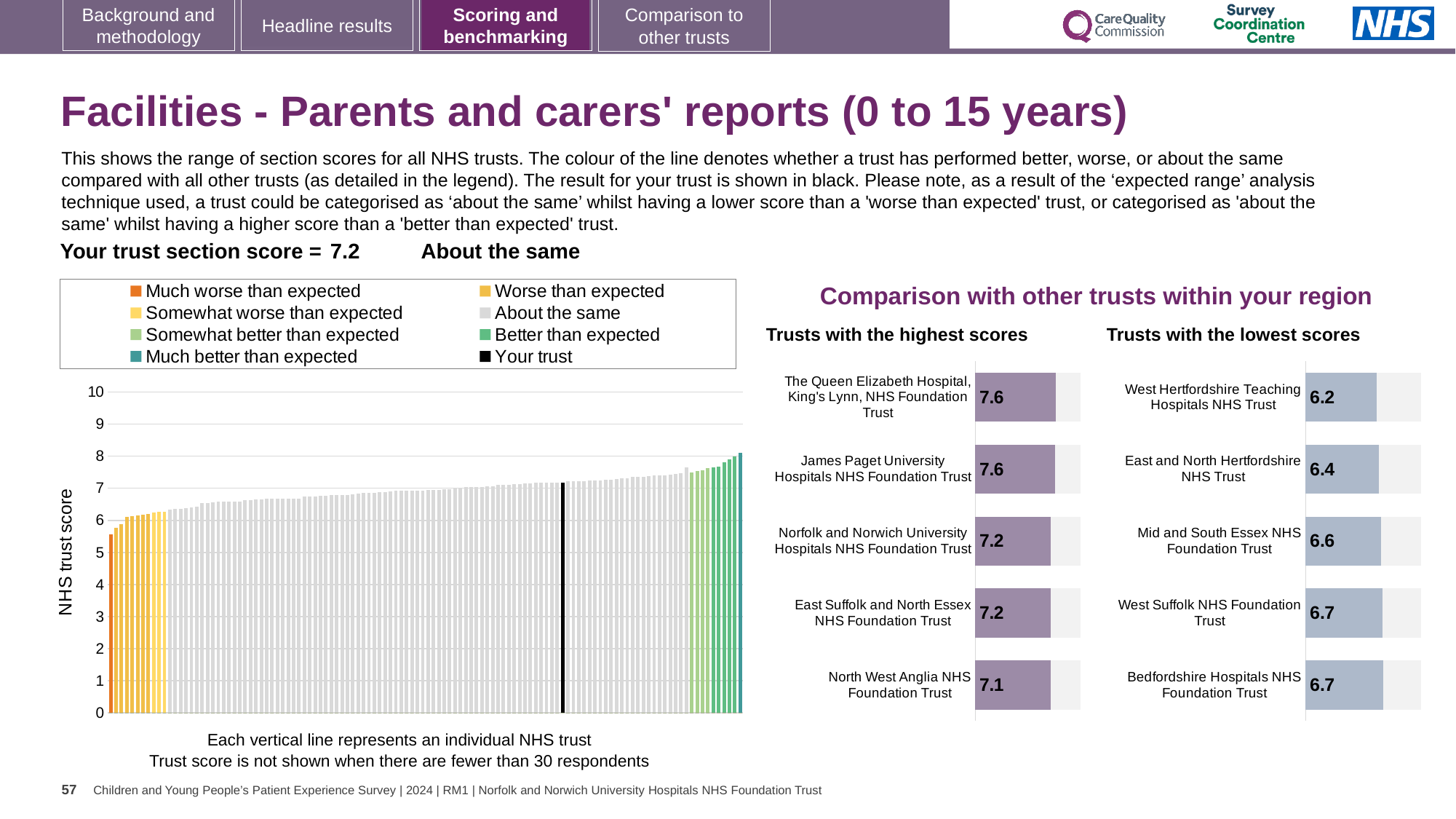
In the 'Trusts with the lowest scores' chart, which has the larger score: East and North Hertfordshire NHS Trust or Mid and South Essex NHS Foundation Trust? Mid and South Essex NHS Foundation Trust What is the label on the vertical axis of the main chart on the left? NHS trust score In the 'Trusts with the lowest scores' chart, what is the score for Mid and South Essex NHS Foundation Trust? 6.6 In the 'Trusts with the highest scores' chart, which trust has the lowest score? North West Anglia NHS Foundation Trust How many entries does the legend of the main chart on the left list? 8 In the 'Trusts with the highest scores' chart, what is the score for North West Anglia NHS Foundation Trust? 7.1 In the main chart on the left, is the value of the lowest (leftmost) bar greater or less than 6? less In the 'Trusts with the lowest scores' chart, which trust has the lowest score? West Hertfordshire Teaching Hospitals NHS Trust In the 'Trusts with the lowest scores' chart, what is the score for West Hertfordshire Teaching Hospitals NHS Trust? 6.2 In the 'Trusts with the highest scores' chart, what is the score for The Queen Elizabeth Hospital, King's Lynn, NHS Foundation Trust? 7.6 In the 'Trusts with the highest scores' chart, what is the difference between the scores of James Paget University Hospitals NHS Foundation Trust and North West Anglia NHS Foundation Trust? 0.5 How many trusts are shown in the 'Trusts with the lowest scores' chart? 5